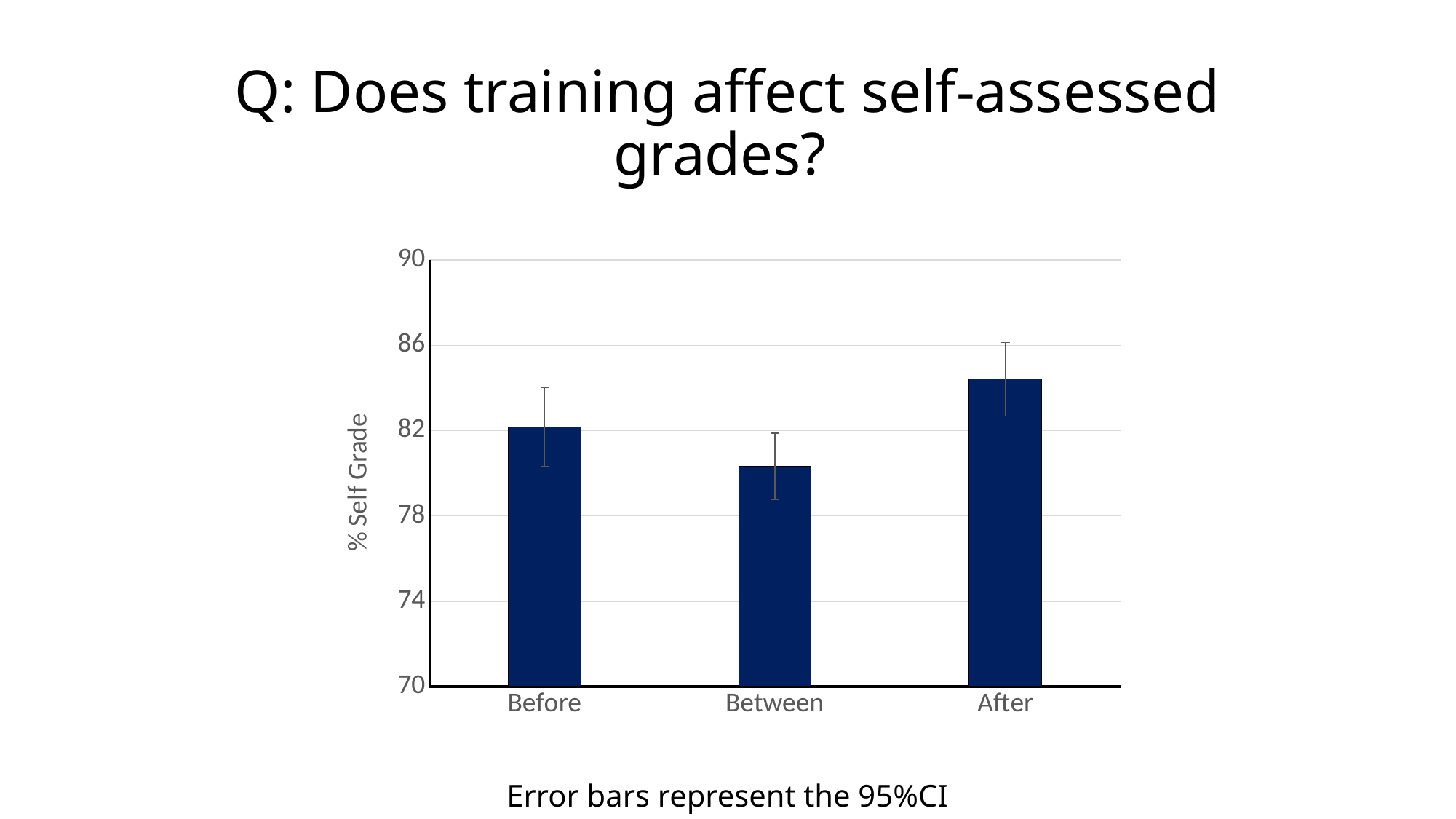
Is the value for After greater or less than 86? less Is the value for Between greater or less than 82? less Is the value for Before greater or less than 78? greater What is the label of the y axis? % Self Grade According to the note below the chart, what do the error bars represent? the 95%CI Which is larger, the value for Before or the value for Between? Before Which is larger, the value for After or the value for Between? After What kind of chart is shown on the slide? bar chart Which category has the highest % Self Grade? After Which category has the lowest % Self Grade? Between How many categories are plotted on the x axis? 3